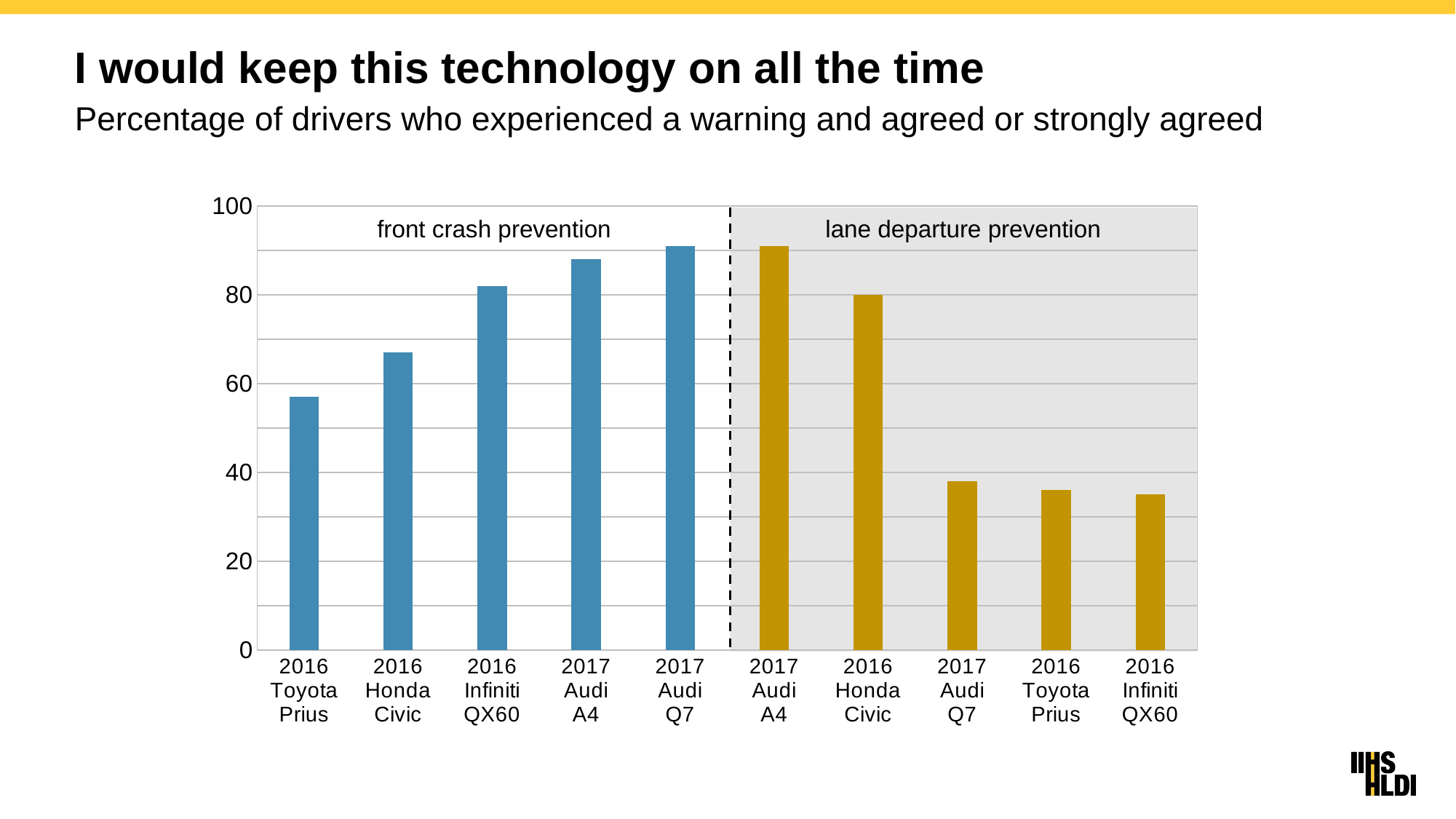
Is the value for the 2017 Audi A4 in the lane departure prevention section greater or less than 80? greater Is the value for the 2016 Infiniti QX60 in the front crash prevention section greater or less than 80? greater Which is larger: the 2016 Honda Civic value for front crash prevention or for lane departure prevention? lane departure prevention Is the value for the 2017 Audi Q7 in the lane departure prevention section greater or less than 40? less Do the values in the front crash prevention section rise or fall from left to right? rise How many bars are plotted in the chart? 10 Which vehicle has the lowest value in the front crash prevention section? 2016 Toyota Prius What colour are the bars in the lane departure prevention section? gold Which vehicle has the highest value in the front crash prevention section? 2017 Audi Q7 What kind of chart is shown on the slide? bar chart Do the values in the lane departure prevention section rise or fall from left to right? fall